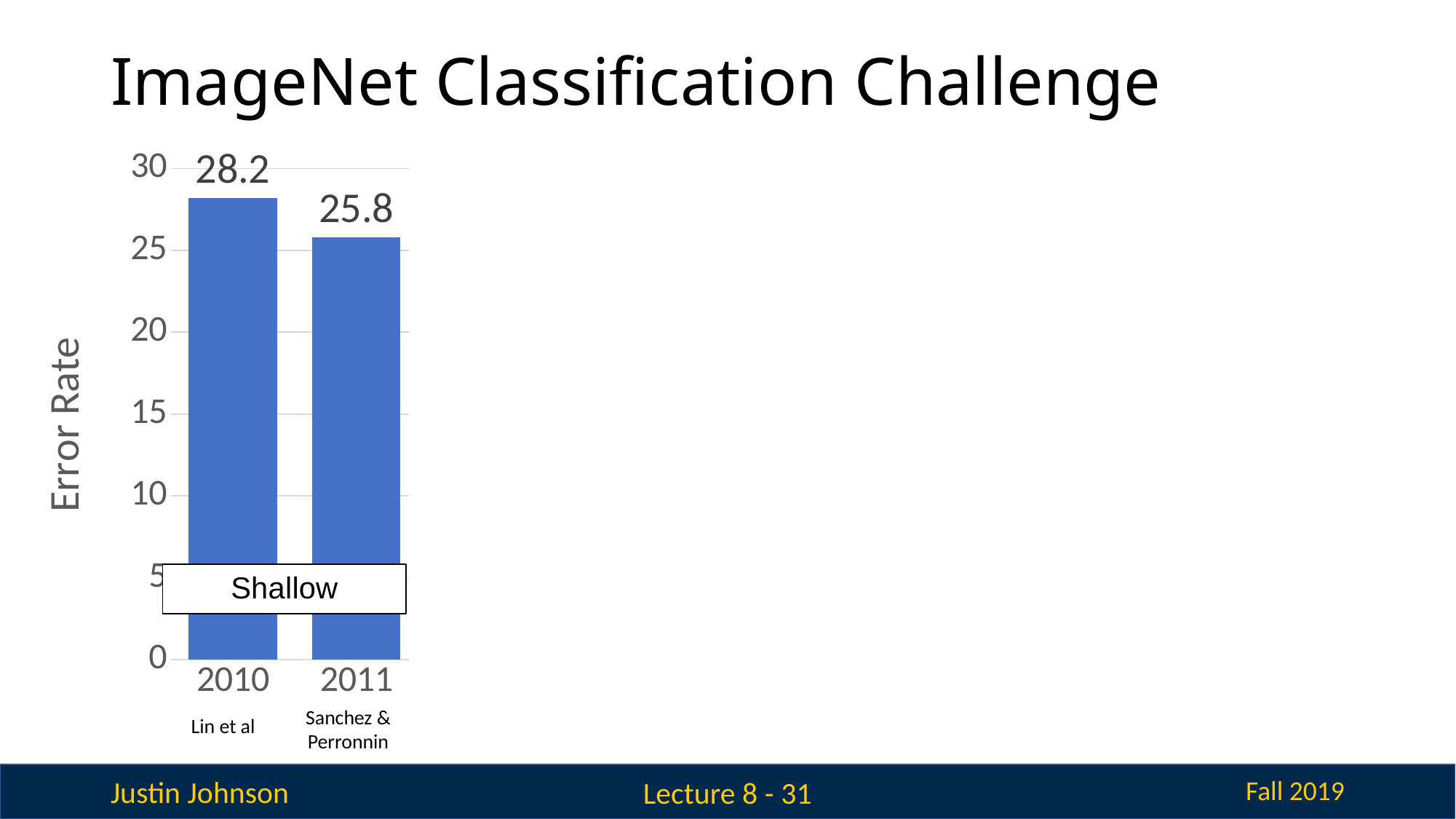
What is the error rate for 2010? 28.2 Is the error rate for 2010 greater or less than 30? less What is the difference between the error rates for 2010 and 2011? 2.4 What is the label on the y axis of the chart? Error Rate Does the error rate rise or fall from 2010 to 2011? fall Is the error rate for 2011 greater or less than 25? greater Which year has the highest error rate? 2010 Which has a larger error rate, 2010 or 2011? 2010 What is the error rate for 2011? 25.8 What kind of chart is shown on the slide? bar chart How many bars are shown in the chart? 2 Which year has the lowest error rate? 2011